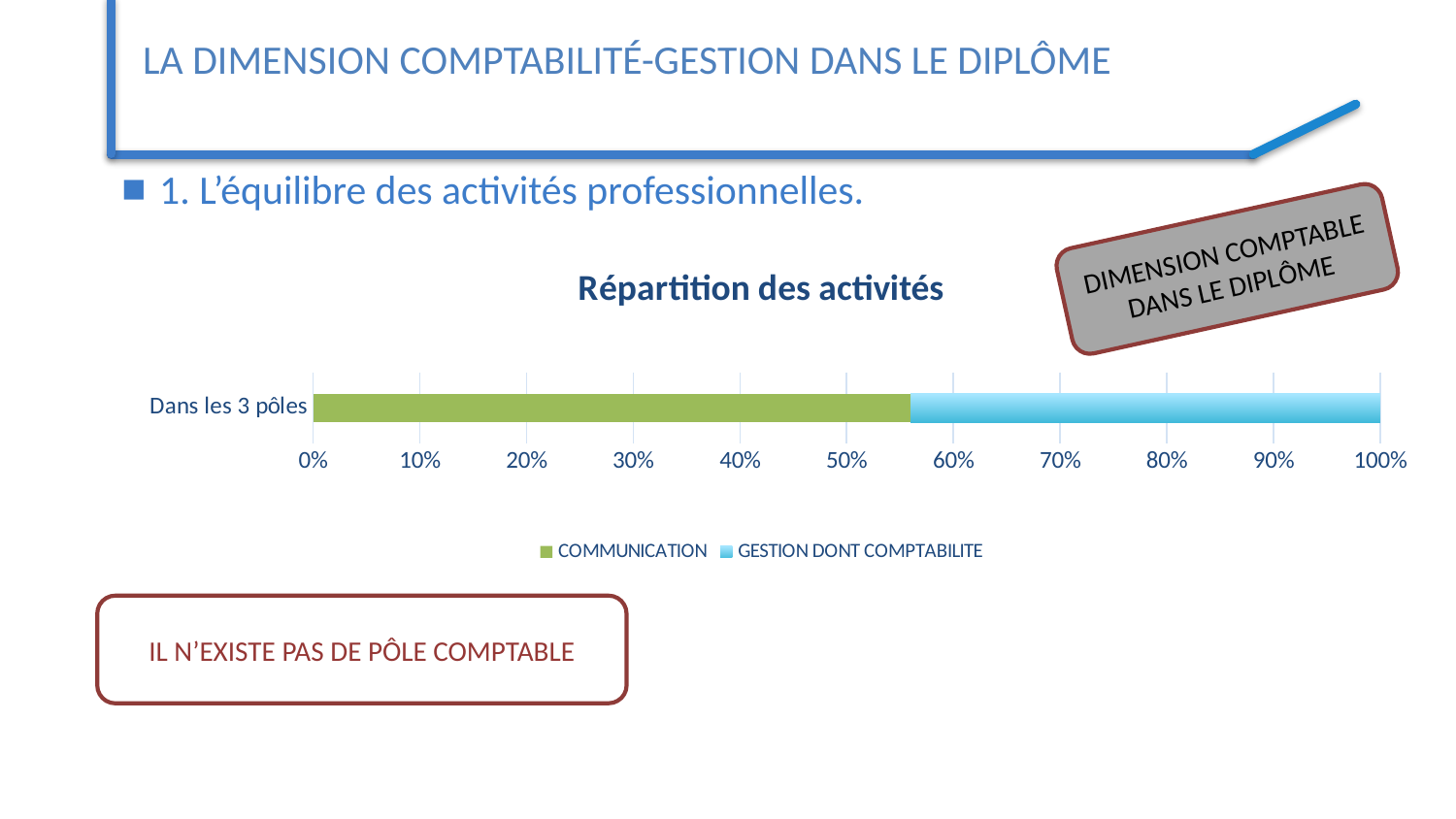
What is the highest value shown on the chart's horizontal axis? 100% How many categories are plotted on the chart's vertical axis? 1 Is the share of GESTION DONT COMPTABILITE for 'Dans les 3 pôles' greater or less than 50%? less What is the name of the single category shown on the chart? Dans les 3 pôles Is the share of COMMUNICATION for 'Dans les 3 pôles' greater or less than 60%? less Is the share of COMMUNICATION for 'Dans les 3 pôles' greater or less than 50%? greater How many series does the chart legend list? 2 What kind of chart is shown on the slide? bar chart Which series takes the larger share of the bar for 'Dans les 3 pôles': COMMUNICATION or GESTION DONT COMPTABILITE? COMMUNICATION What is the title of the chart? Répartition des activités Which series has the largest share in the chart? COMMUNICATION